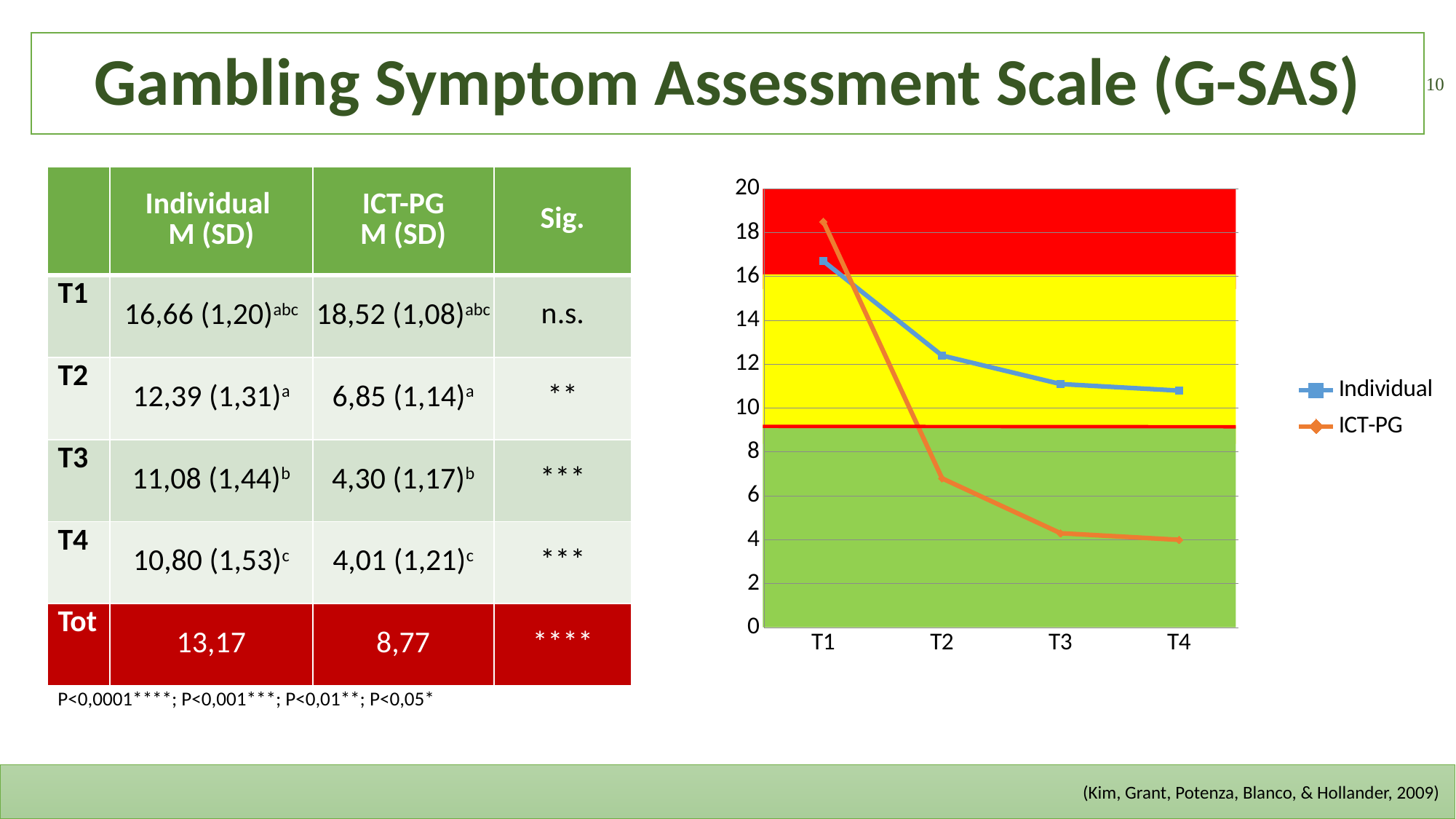
Is the value for ICT-PG at T2 greater or less than 8? less At T4, which series has the higher value, Individual or ICT-PG? Individual Is the value for ICT-PG at T1 greater or less than 18? greater Do the values of the Individual series rise or fall from T1 to T4? fall How many time points are plotted along the x axis of the chart? 4 Do the values of the ICT-PG series rise or fall from T1 to T4? fall Is the value for Individual at T4 greater or less than 10? greater At which time point is the ICT-PG series highest? T1 Which two series are listed in the chart legend? Individual and ICT-PG How many series does the chart legend list? 2 What kind of chart is shown on the slide? line chart At T1, which series has the higher value, Individual or ICT-PG? ICT-PG